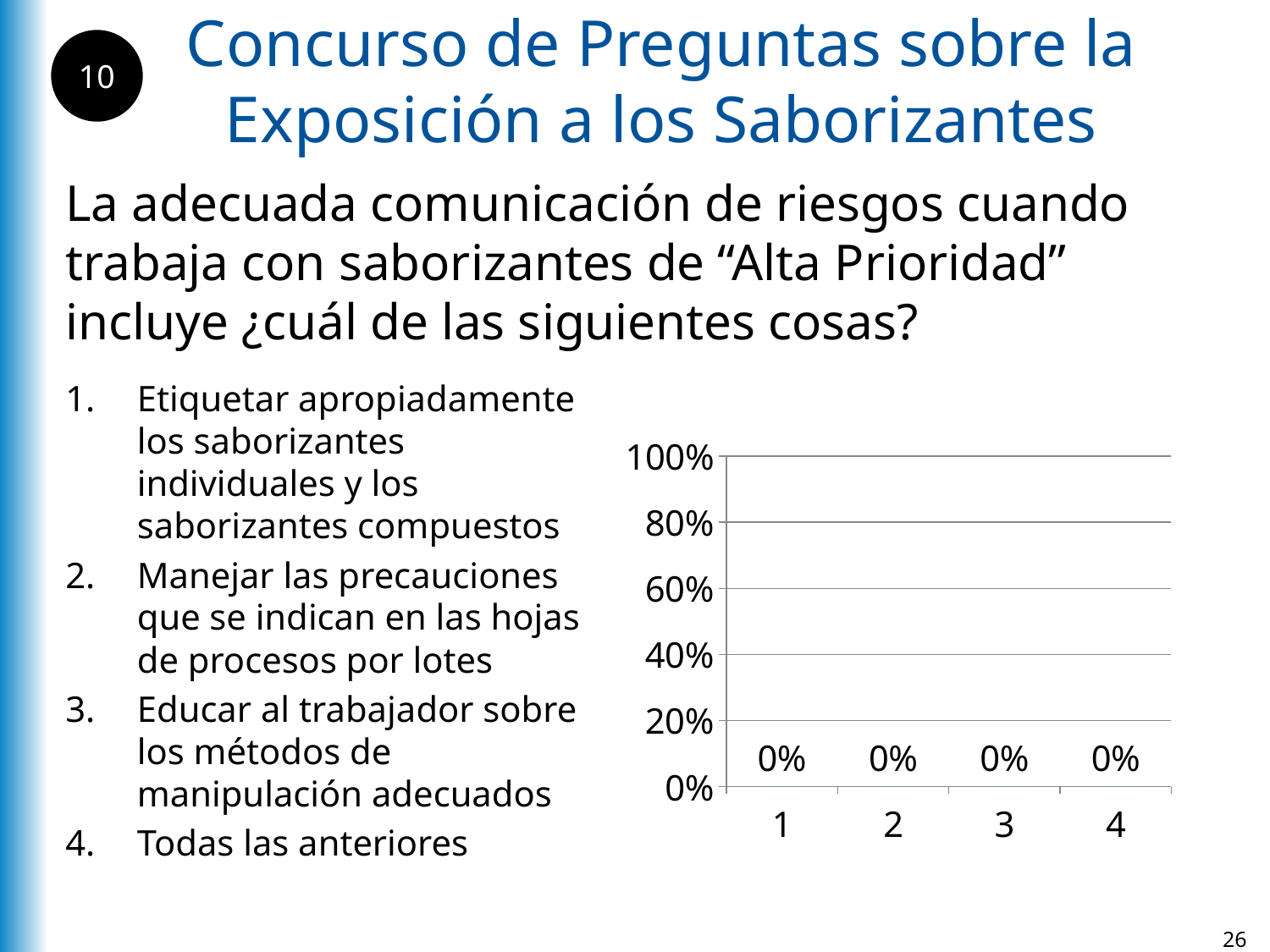
What is the interval between the tick marks on the y axis? 20% Is the value for category 3 greater or less than 40%? less How many categories are shown on the x axis of the chart? 4 What kind of chart is shown on the slide? bar chart What is the highest value shown on the y axis of the chart? 100% What is the value for category 3? 0% What is the value for category 1? 0% What is the difference between the values for category 1 and category 4? 0% Is the value for category 2 greater or less than 20%? less What is the value for category 4? 0% What is the value for category 2? 0%